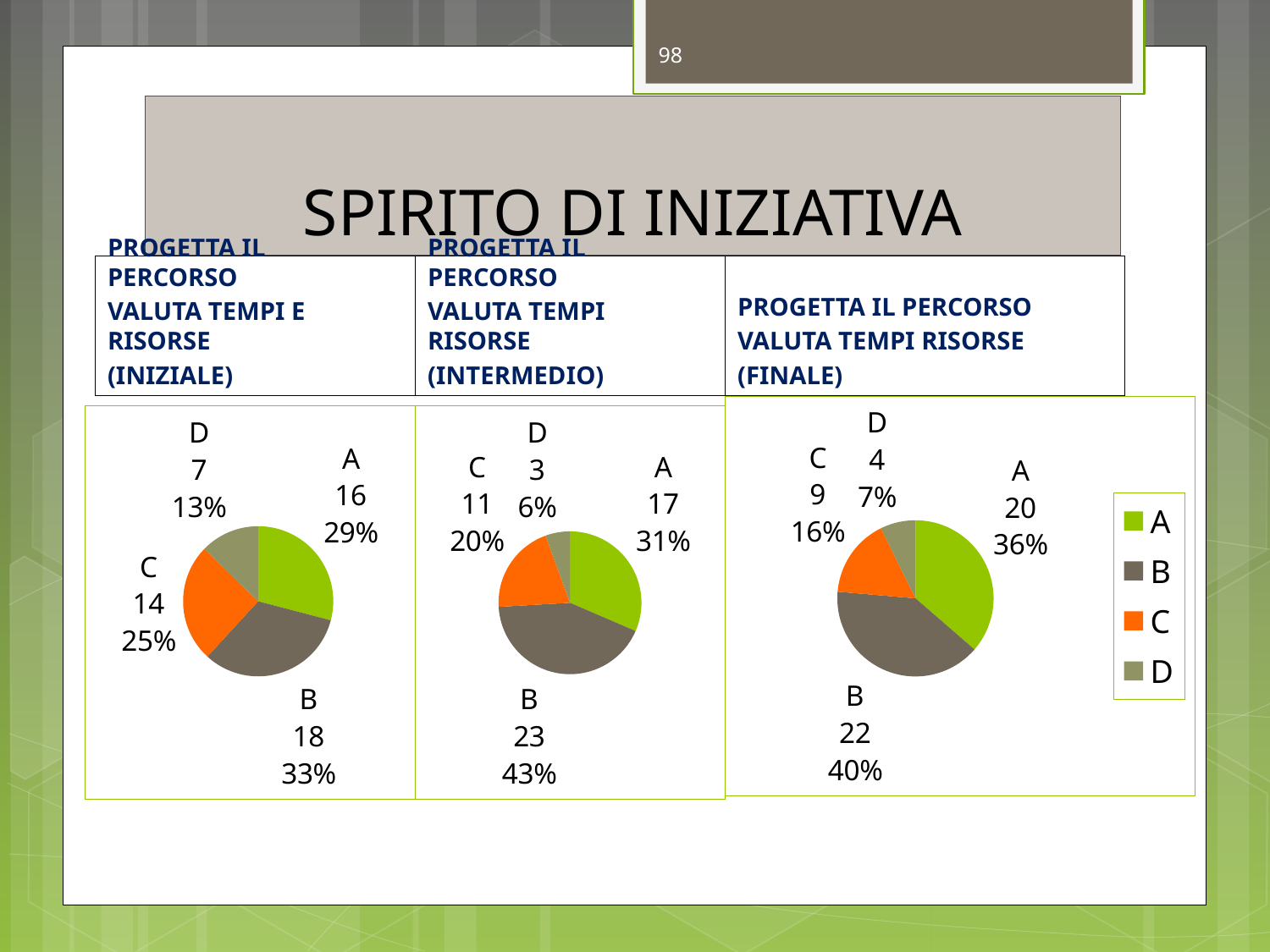
In the middle pie chart (INTERMEDIO), what percentage share does category A have? 31% In the right pie chart (FINALE), what is the difference between the values for B and A? 2 In the right pie chart (FINALE), which category has the smallest share? D In the left pie chart (INIZIALE), which is larger, the value for A or the value for C? A How many categories does each pie chart on the slide show? 4 In the middle pie chart (INTERMEDIO), what is the value for category D? 3 In the left pie chart (INIZIALE), what is the value for category B? 18 What type of chart is used for the three charts on the slide? Pie chart In the left pie chart (INIZIALE), what percentage share does category C have? 25% In the right pie chart (FINALE), what is the value for category C? 9 In the middle pie chart (INTERMEDIO), which category has the largest share? B In the legend on the right of the slide, which colour represents category C? Orange